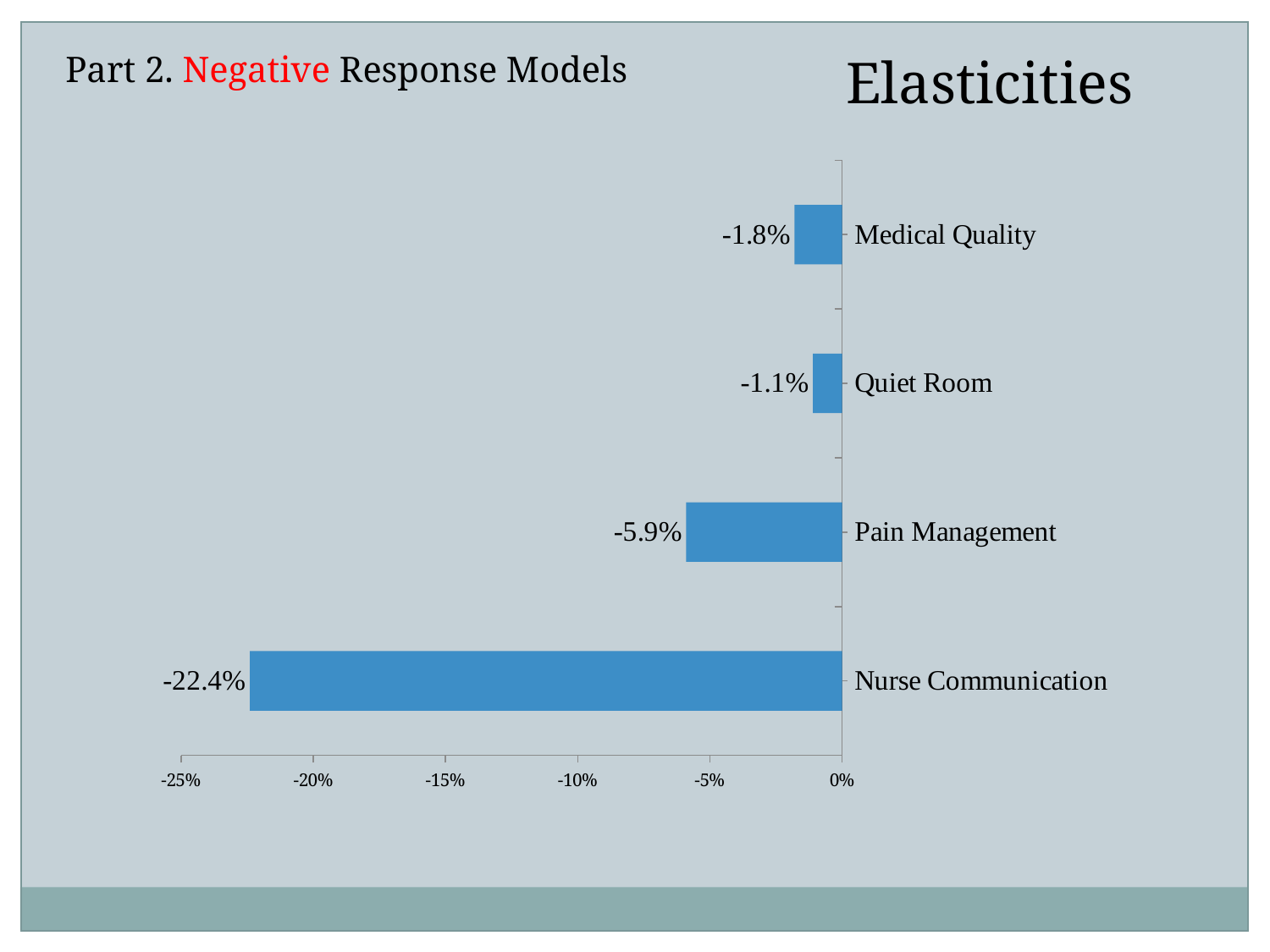
What is the elasticity value for Nurse Communication? -22.4% Which category has the most negative elasticity? Nurse Communication What is the difference between the elasticity for Nurse Communication and Pain Management? 16.5% Is the value for Nurse Communication less than -20%? Yes What kind of chart is shown on the slide? Bar chart What is the elasticity value for Quiet Room? -1.1% What is the elasticity value for Pain Management? -5.9% How many categories are shown in the chart? 4 Which category has the elasticity closest to zero? Quiet Room What is the elasticity value for Medical Quality? -1.8% Which has a larger magnitude of elasticity, Pain Management or Medical Quality? Pain Management What is the difference between the elasticity for Medical Quality and Quiet Room? 0.7%